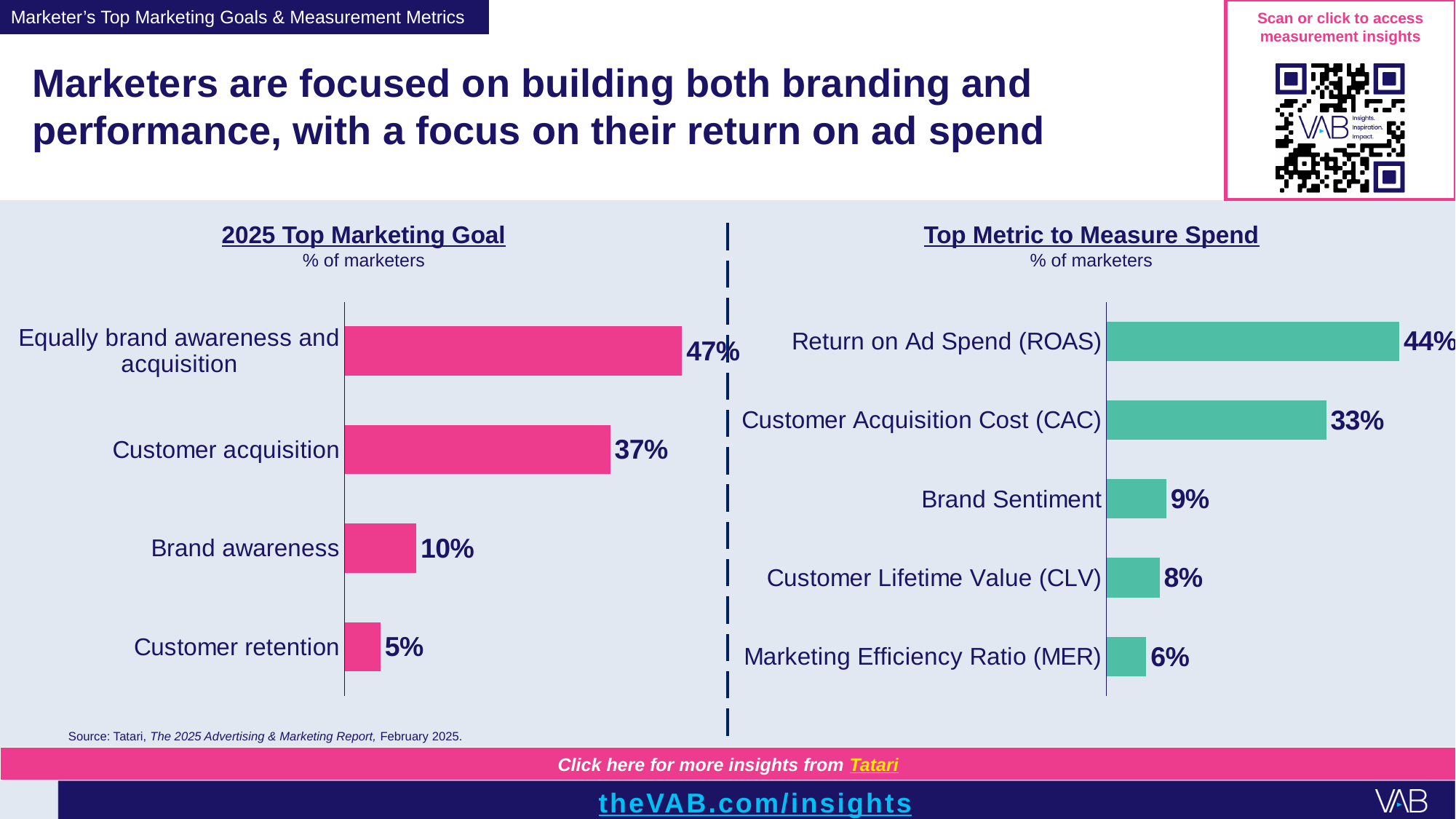
In the 'Top Metric to Measure Spend' chart, which metric has the lowest percentage of marketers? Marketing Efficiency Ratio (MER) In the 'Top Metric to Measure Spend' chart, which is larger: 'Brand Sentiment' or 'Customer Lifetime Value (CLV)'? Brand Sentiment In the '2025 Top Marketing Goal' chart, what percentage of marketers chose 'Customer acquisition'? 37% In the 'Top Metric to Measure Spend' chart, what is the difference between 'Return on Ad Spend (ROAS)' and 'Customer Acquisition Cost (CAC)'? 11% In the 'Top Metric to Measure Spend' chart, what percentage of marketers chose 'Customer Acquisition Cost (CAC)'? 33% In the '2025 Top Marketing Goal' chart, which goal has the lowest percentage of marketers? Customer retention In the 'Top Metric to Measure Spend' chart, how many metrics are shown? 5 In the '2025 Top Marketing Goal' chart, how many goals are shown? 4 What type of chart is the '2025 Top Marketing Goal' chart? Bar chart In the 'Top Metric to Measure Spend' chart, which metric has the highest percentage of marketers? Return on Ad Spend (ROAS) In the '2025 Top Marketing Goal' chart, what is the difference between 'Equally brand awareness and acquisition' and 'Customer acquisition'? 10% In the '2025 Top Marketing Goal' chart, which goal has the highest percentage of marketers? Equally brand awareness and acquisition